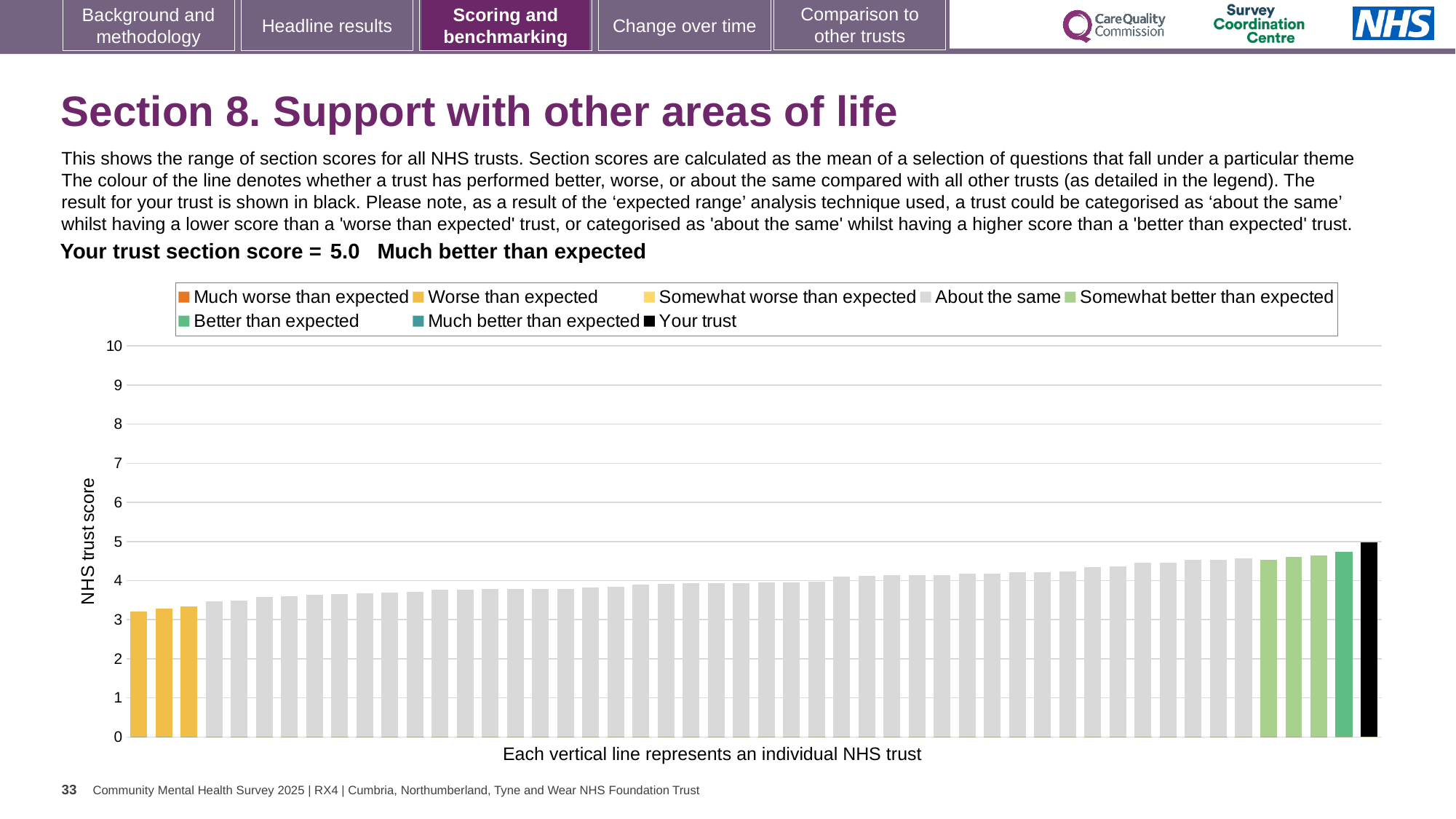
Is the value of the lowest bar in the chart greater or less than 3? greater How many bars are coloured as 'Worse than expected'? 3 Which category is your trust's section score placed in? Much better than expected What is the label on the y axis of the chart? NHS trust score Is the value for your trust greater or less than 4? greater Which is larger, the leftmost bar or the rightmost bar? the rightmost bar Which bar has the highest value in the chart? Your trust Do the bar values rise or fall from left to right along the x axis? rise What kind of chart is shown on the slide? bar chart How many entries does the chart legend list? 8 What is the section score for your trust? 5.0 Is the value of the lowest bar in the chart greater or less than 4? less